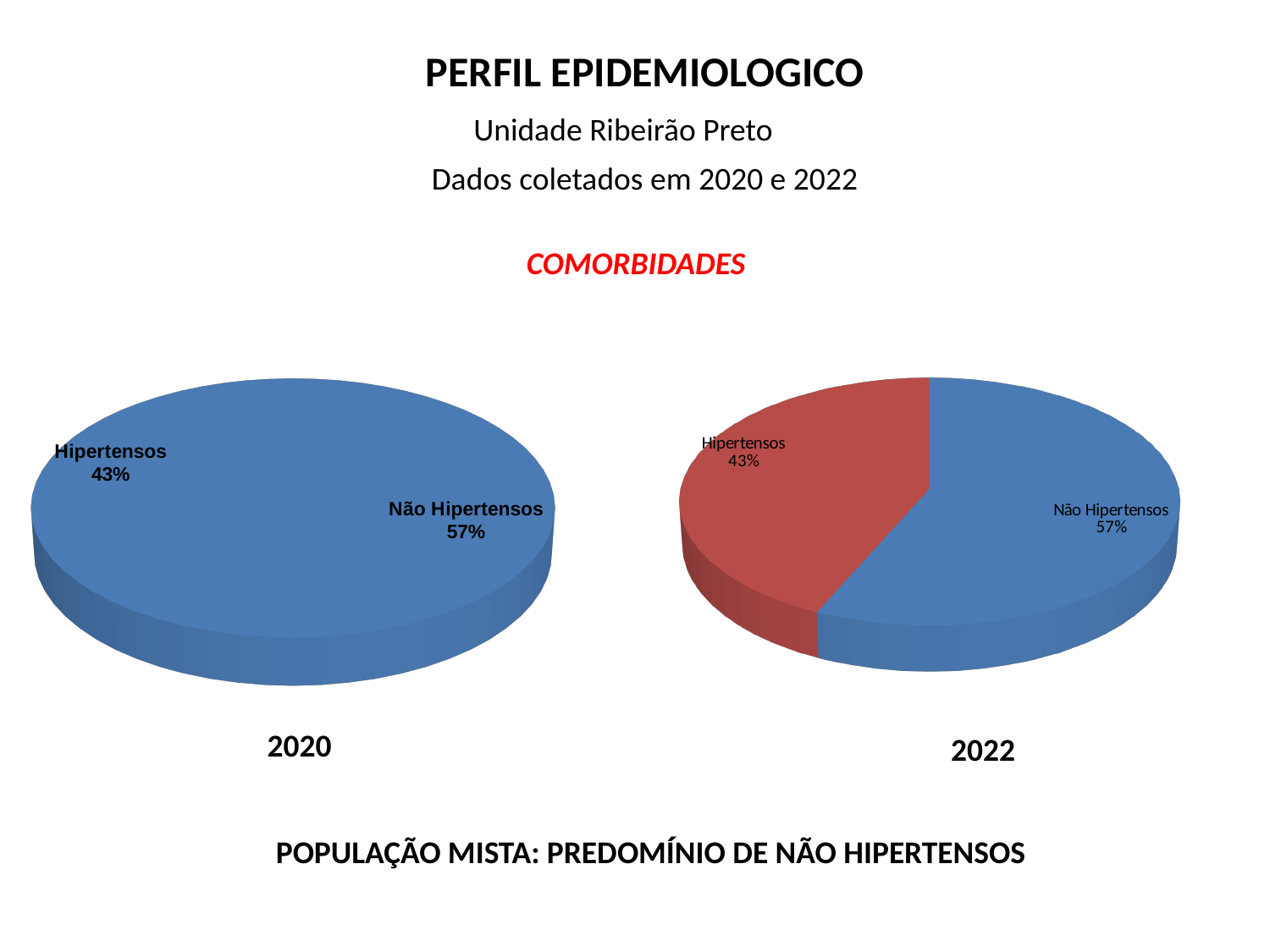
In the 2020 pie chart, what share is labelled for Hipertensos? 43% In the 2022 pie chart, what is the difference in percentage points between Não Hipertensos and Hipertensos? 14 In the 2020 pie chart, what share is labelled for Não Hipertensos? 57% In the 2022 pie chart, which category has the largest share? Não Hipertensos What year label appears under the right-hand pie chart? 2022 In the 2022 pie chart, what colour is the Hipertensos slice? Red In the 2022 pie chart, what share is labelled for Hipertensos? 43% What kind of chart is the chart labelled 2020? Pie chart In the 2020 pie chart, which category has the smallest share? Hipertensos How many categories does the 2022 pie chart show? 2 In the 2020 pie chart, which is larger: Hipertensos or Não Hipertensos? Não Hipertensos